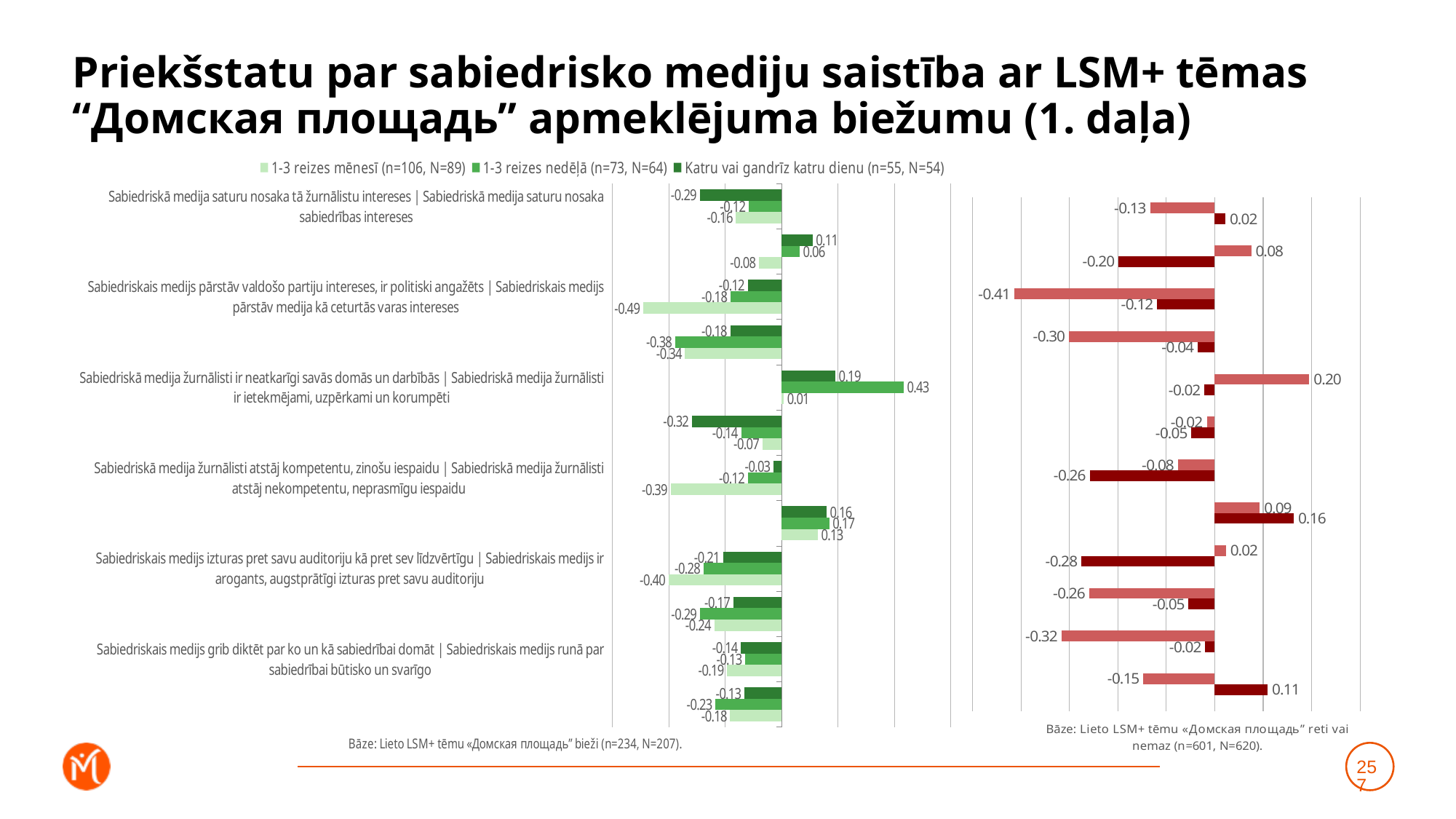
In the right (red) chart, what is the lowest value shown by any bar? -0.41 In the left chart, for the top category 'Sabiedriskā medija saturu nosaka tā žurnālistu intereses | Sabiedriskā medija saturu nosaka sabiedrības intereses', what is the value for 'Katru vai gandrīz katru dienu'? -0.29 In the right (red) chart, what is the highest value shown by any bar? 0.20 In the left (green) chart, what is the lowest value shown by any bar? -0.49 What kind of chart is the left chart on the slide? Bar chart In the left chart, in the group where the '1-3 reizes nedēļā' bar is 0.43, what is the value for 'Katru vai gandrīz katru dienu'? 0.19 How many series does the legend of the left chart list? 3 What is the sample size given in the legend for the series '1-3 reizes mēnesī' in the left chart? n=106, N=89 In the left chart, what is the difference between the 0.43 bar and the 0.19 bar in the same group? 0.24 In the left (green) chart, what is the highest value shown by any bar? 0.43 How many groups of bars are plotted in the left chart? 12 In the top group of the left chart, which is larger: the '1-3 reizes nedēļā' value (-0.12) or the 'Katru vai gandrīz katru dienu' value (-0.29)? 1-3 reizes nedēļā (-0.12)